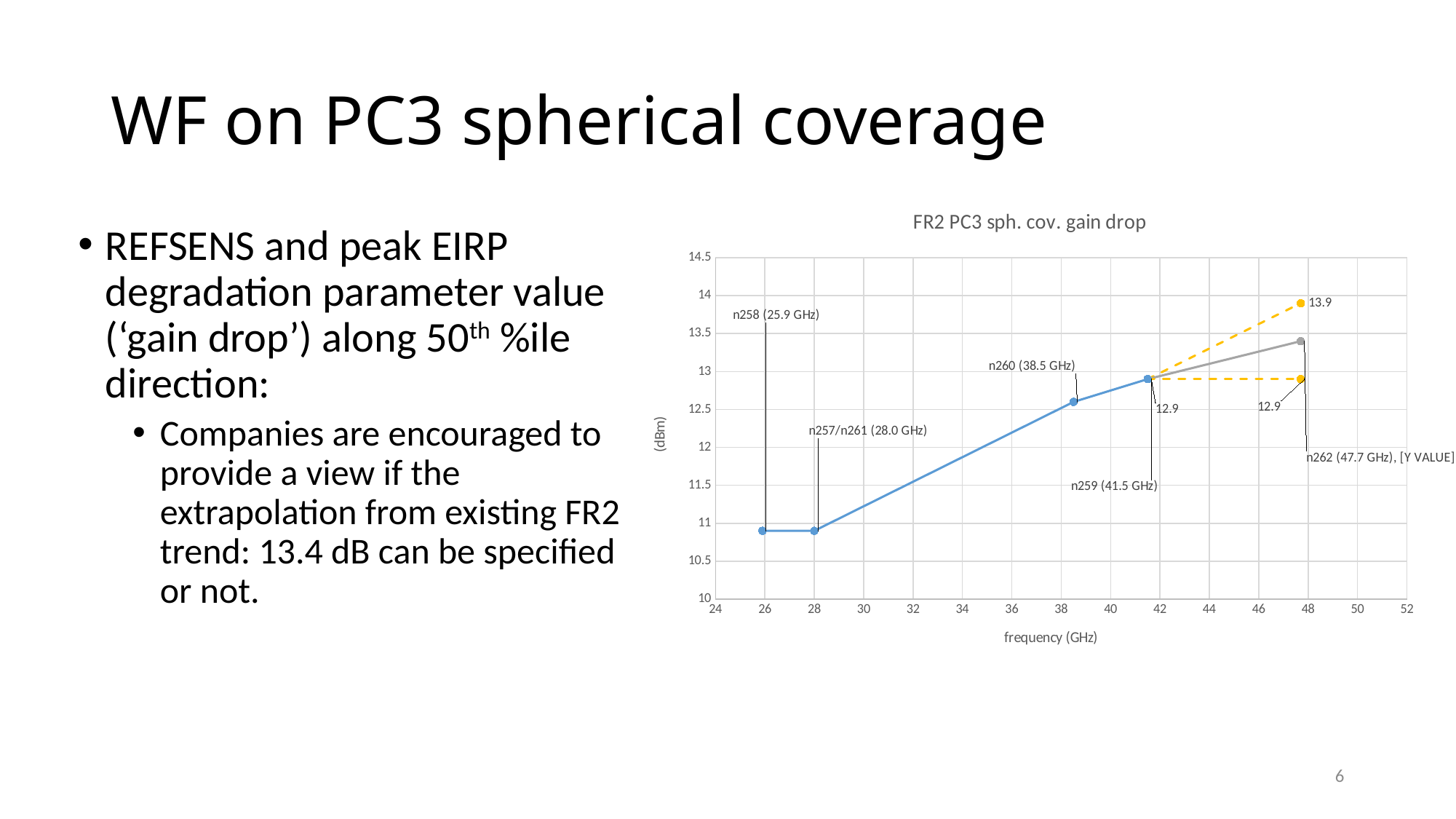
Do the values along the blue line rise or fall as frequency increases from 28 GHz to 41.5 GHz? rise Which has the larger value, n260 (38.5 GHz) or n259 (41.5 GHz)? n259 (41.5 GHz) What value is labeled at the lower yellow dashed-line point at 47.7 GHz? 12.9 Is the value for n258 (25.9 GHz) greater or less than 12? less What kind of chart is shown on the slide? line chart What is the title of the chart? FR2 PC3 sph. cov. gain drop What is the difference between the upper (13.9) and lower (12.9) yellow dashed-line values at 47.7 GHz? 1.0 What value is labeled at the upper yellow dashed-line point at 47.7 GHz? 13.9 What value is labeled at the n259 (41.5 GHz) point? 12.9 Is the value for n260 (38.5 GHz) greater or less than 12? greater What is the label of the x axis of the chart? frequency (GHz) Is the value of the gray-line point at n262 (47.7 GHz) greater or less than 13? greater